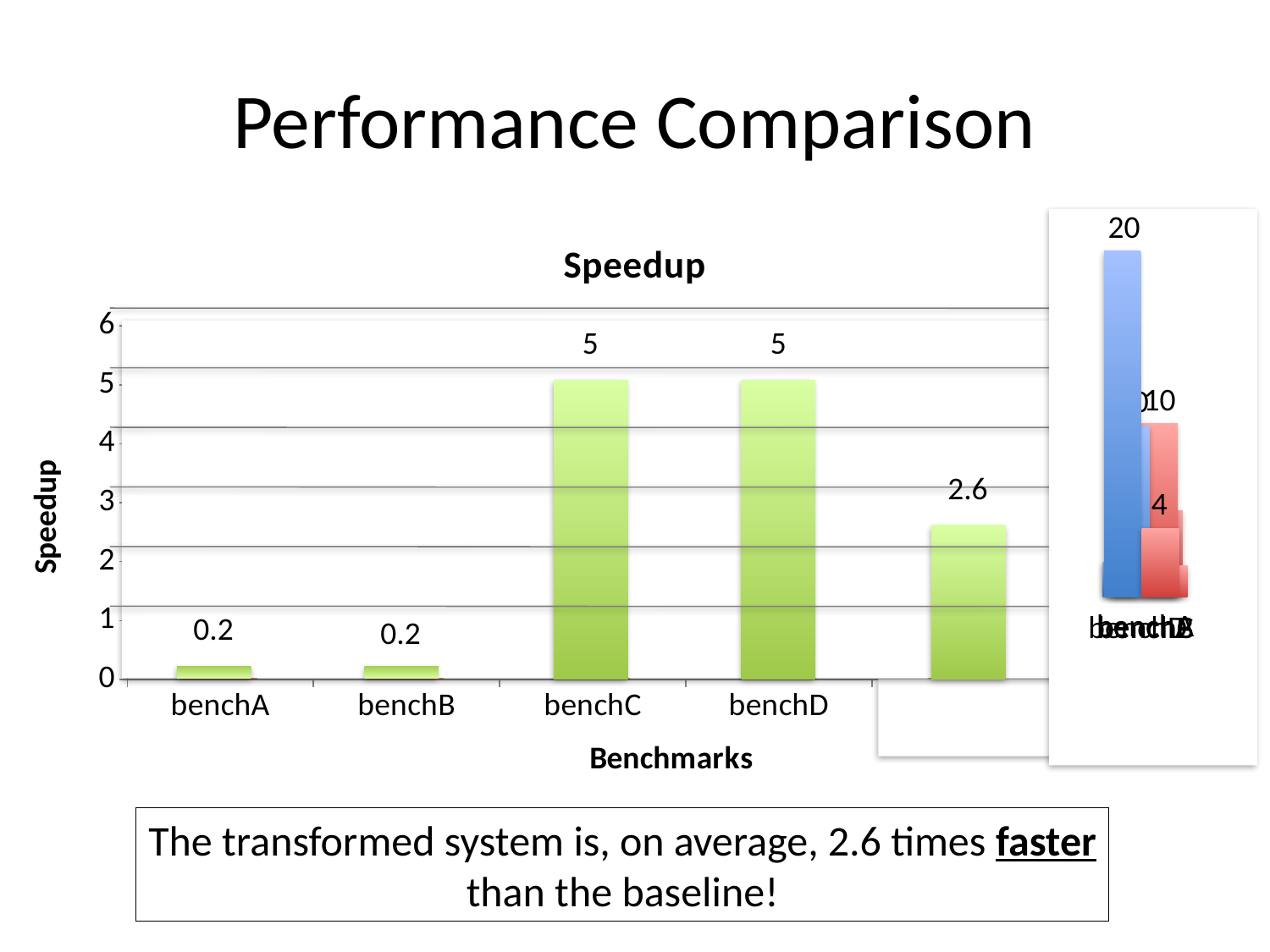
In the Speedup chart, what is the speedup value for benchC? 5 In the Speedup chart, which benchmarks have the highest speedup? benchC and benchD In the Speedup chart, what is the difference between the speedup of benchC and benchA? 4.8 In the Speedup chart, what is the speedup value for benchD? 5 In the Speedup chart, what is the speedup value for benchB? 0.2 What is the title of the y axis of the Speedup chart? Speedup In the Speedup chart, which benchmarks have the lowest speedup? benchA and benchB In the Speedup chart, which has a larger speedup, benchD or benchB? benchD In the Speedup chart, is the value for benchC greater or less than 4? greater What kind of chart is the Speedup chart? bar chart In the Speedup chart, what is the speedup value for benchA? 0.2 What is the title of the x axis of the Speedup chart? Benchmarks